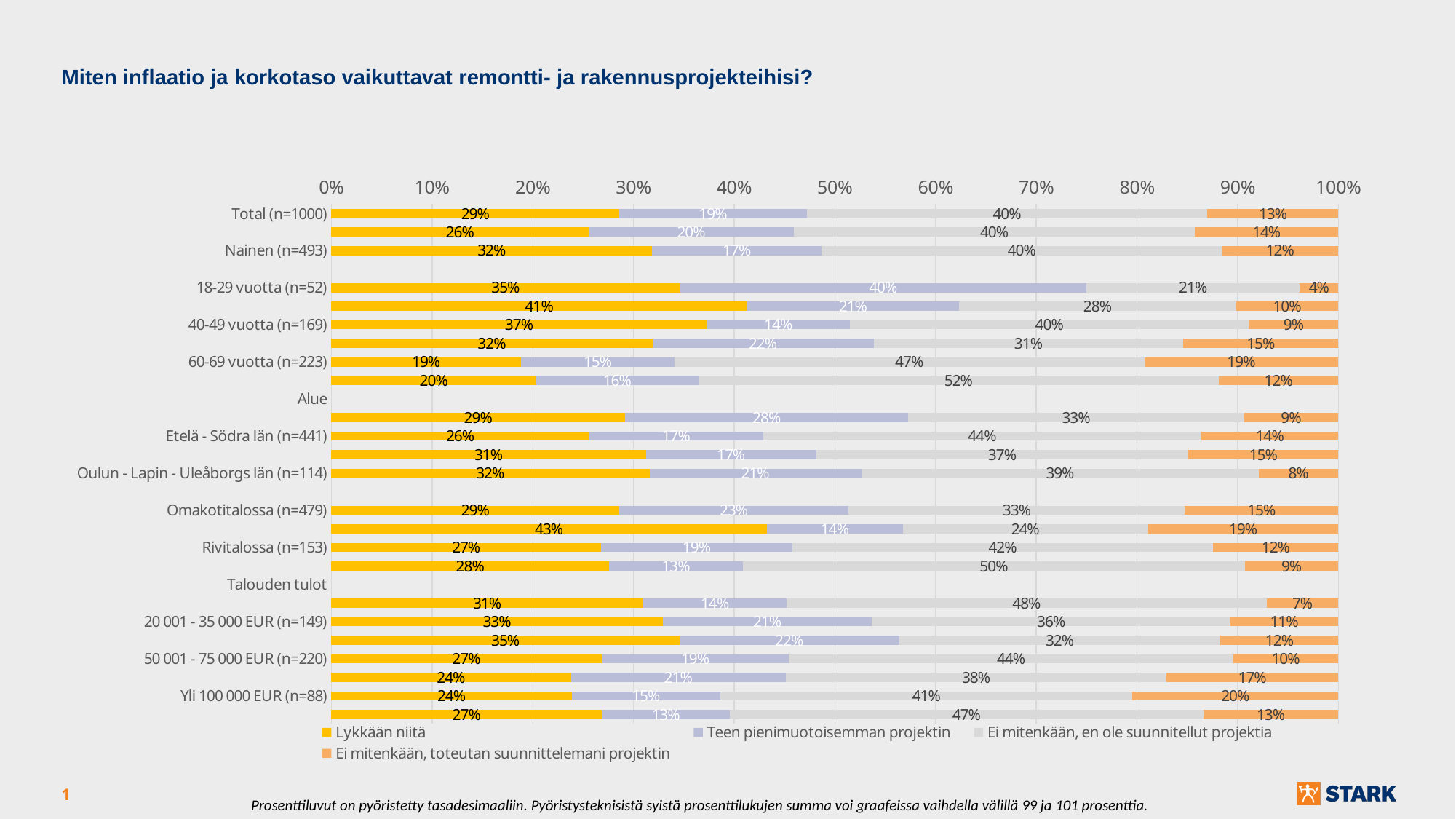
What is the value of 'Teen pienimuotoisemman projektin' for Omakotitalossa (n=479)? 23% What is the difference between the 'Lykkään niitä' values for 40-49 vuotta (n=169) and 60-69 vuotta (n=223)? 18 percentage points Which series has the largest share in the Total (n=1000) bar? Ei mitenkään, en ole suunnitellut projektia What is the value of 'Ei mitenkään, toteutan suunnittelemani projektin' for Yli 100 000 EUR (n=88)? 20% Which has a higher 'Ei mitenkään, en ole suunnitellut projektia' value: Etelä - Södra län (n=441) or Oulun - Lapin - Uleåborgs län (n=114)? Etelä - Södra län (n=441) What is the value of 'Teen pienimuotoisemman projektin' for 18-29 vuotta (n=52)? 40% What is the value of 'Lykkään niitä' for Nainen (n=493)? 32% What is the title of the chart? Miten inflaatio ja korkotaso vaikuttavat remontti- ja rakennusprojekteihisi? What is the value of 'Ei mitenkään, en ole suunnitellut projektia' for 60-69 vuotta (n=223)? 47% How many series does the legend list? 4 What is the value of 'Lykkään niitä' for Total (n=1000)? 29% What type of chart is shown on the slide? Stacked bar chart